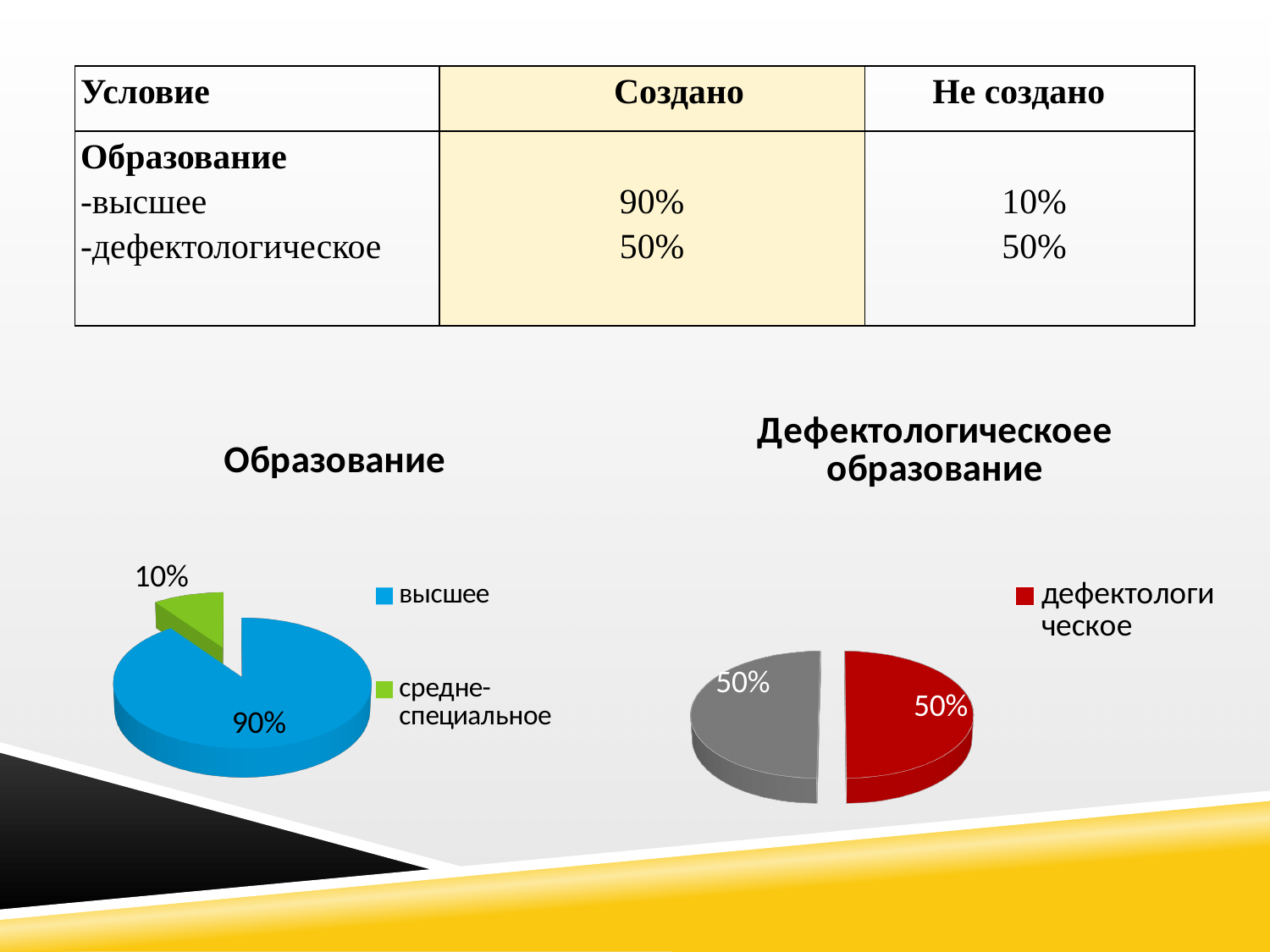
In the chart titled "Образование", what is the value for средне-специальное? 10% In the chart titled "Образование", which category has the largest slice? высшее In the chart titled "Образование", how many slices does the pie have? 2 In the chart titled "Дефектологическоее образование", what is the value for дефектологическое? 50% In the chart titled "Образование", what is the value for высшее? 90% What kind of chart is the chart titled "Образование"? pie chart In the chart titled "Образование", what is the difference between the values for высшее and средне-специальное? 80% What kind of chart is the chart titled "Дефектологическоее образование"? pie chart In the chart titled "Дефектологическоее образование", what colour is the slice for дефектологическое? red In the chart titled "Образование", which category has the smallest slice? средне-специальное In the chart titled "Образование", which is larger: высшее or средне-специальное? высшее In the chart titled "Дефектологическоее образование", how many slices does the pie have? 2